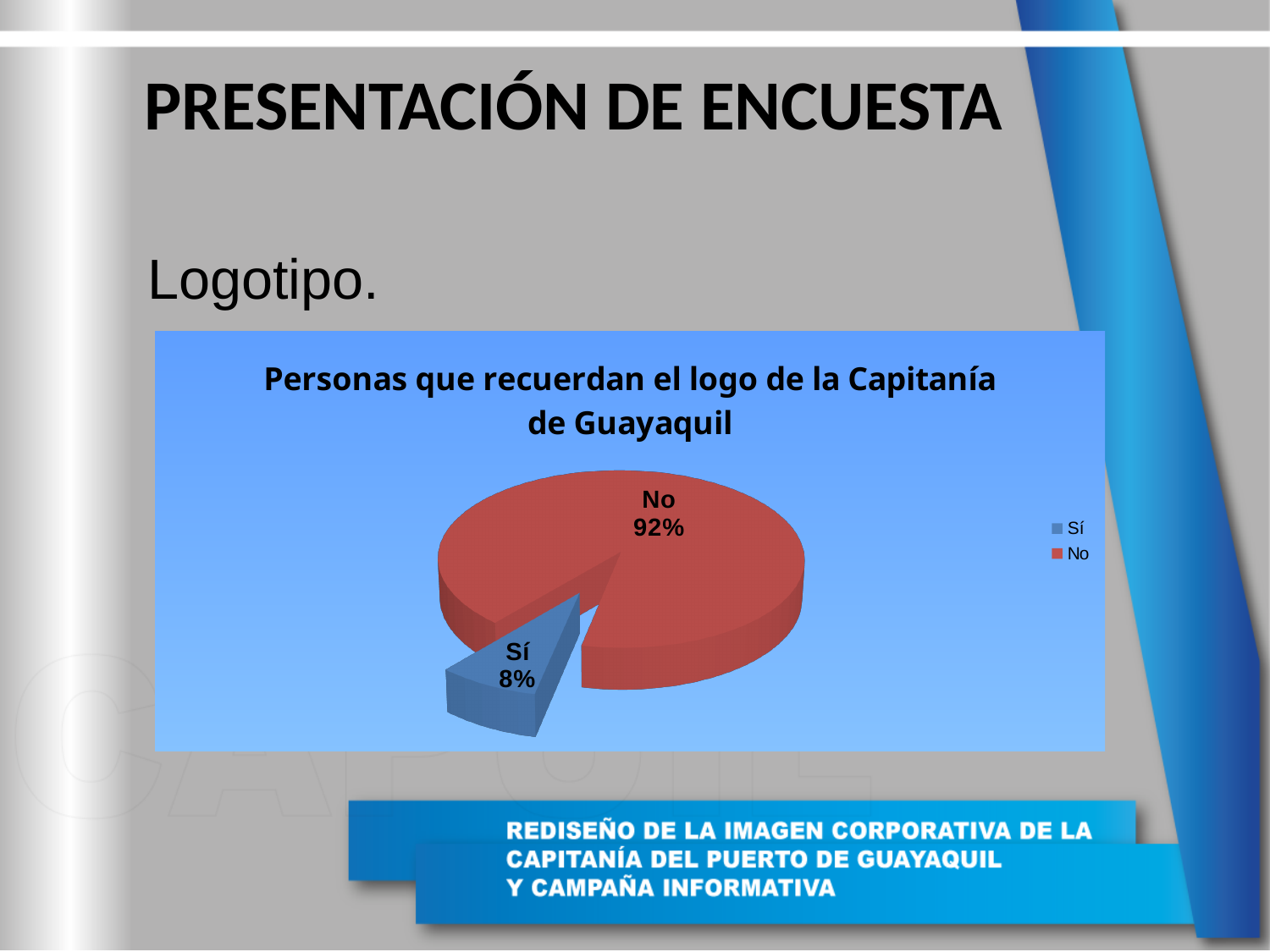
What share of the pie does the "Sí" slice represent? 8% What colour is the "No" slice? red What is the difference in percentage points between the "No" and "Sí" slices? 84 Which is larger, the "Sí" slice or the "No" slice? No How many entries does the legend list? 2 What is the title of the chart? Personas que recuerdan el logo de la Capitanía de Guayaquil What percentage of people answered "No"? 92% What kind of chart is shown on the slide? pie chart Which slice of the pie is the largest? No How many slices does the pie chart have? 2 Which slice of the pie is the smallest? Sí What percentage of people answered "Sí"? 8%